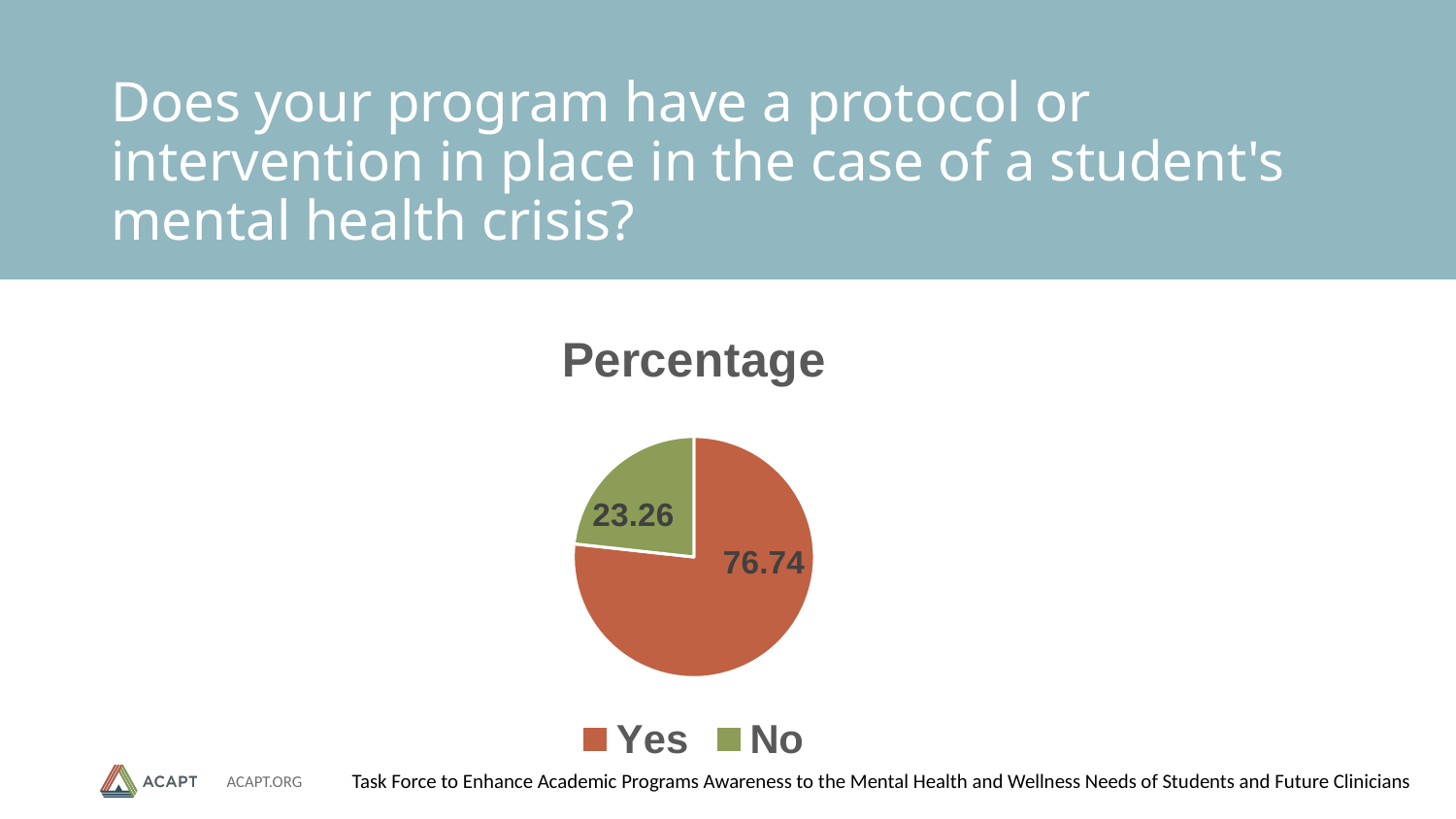
How many entries does the legend list? 2 What is the value for Yes? 76.74 Which category has the smallest slice? No What is the value for No? 23.26 Which category has the largest slice? Yes What colour is the Yes slice? red-orange What is the title of the chart? Percentage What type of chart is shown on the slide? pie chart What is the difference between the Yes and No values? 53.48 How many slices does the pie chart have? 2 Which is larger, the value for Yes or the value for No? Yes